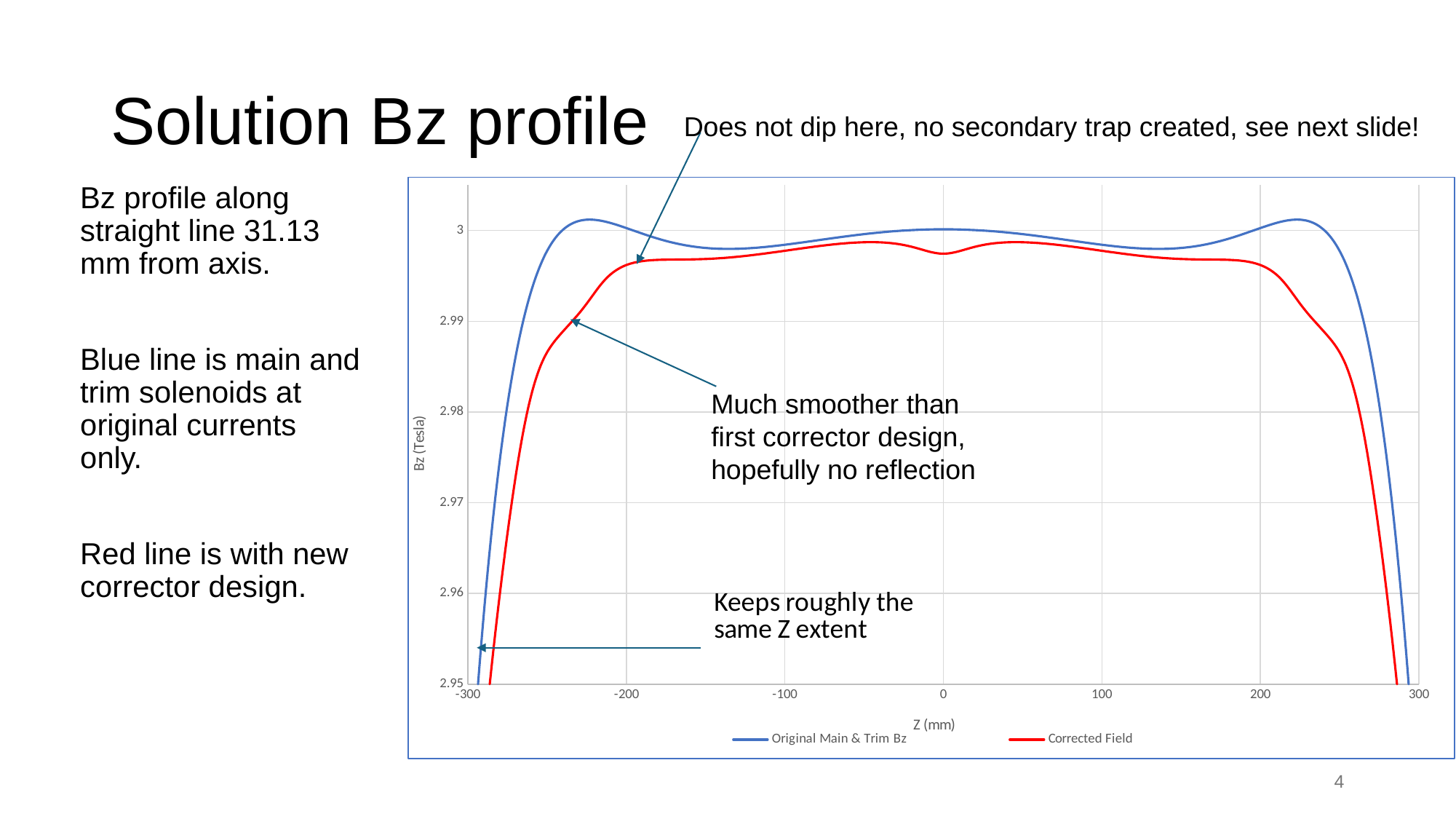
What are the two series named in the chart legend? Original Main & Trim Bz and Corrected Field What is the label of the chart's vertical axis? Bz (Tesla) How many series does the chart legend list? 2 Does the Original Main & Trim Bz series rise or fall as Z goes from 200 to 300? fall Is the Corrected Field value at Z = -250 greater or less than 2.98? greater Is the Corrected Field value at Z = 0 greater or less than 3? less Does the Corrected Field series rise or fall as Z goes from -300 to -200? rise Which series reaches the higher peak Bz value? Original Main & Trim Bz What kind of chart is shown on the slide? line chart At Z = -200, which series has the higher Bz value, Original Main & Trim Bz or Corrected Field? Original Main & Trim Bz At Z = 0, which series has the higher Bz value, Original Main & Trim Bz or Corrected Field? Original Main & Trim Bz Is the Original Main & Trim Bz value at Z = -250 greater or less than 2.99? greater